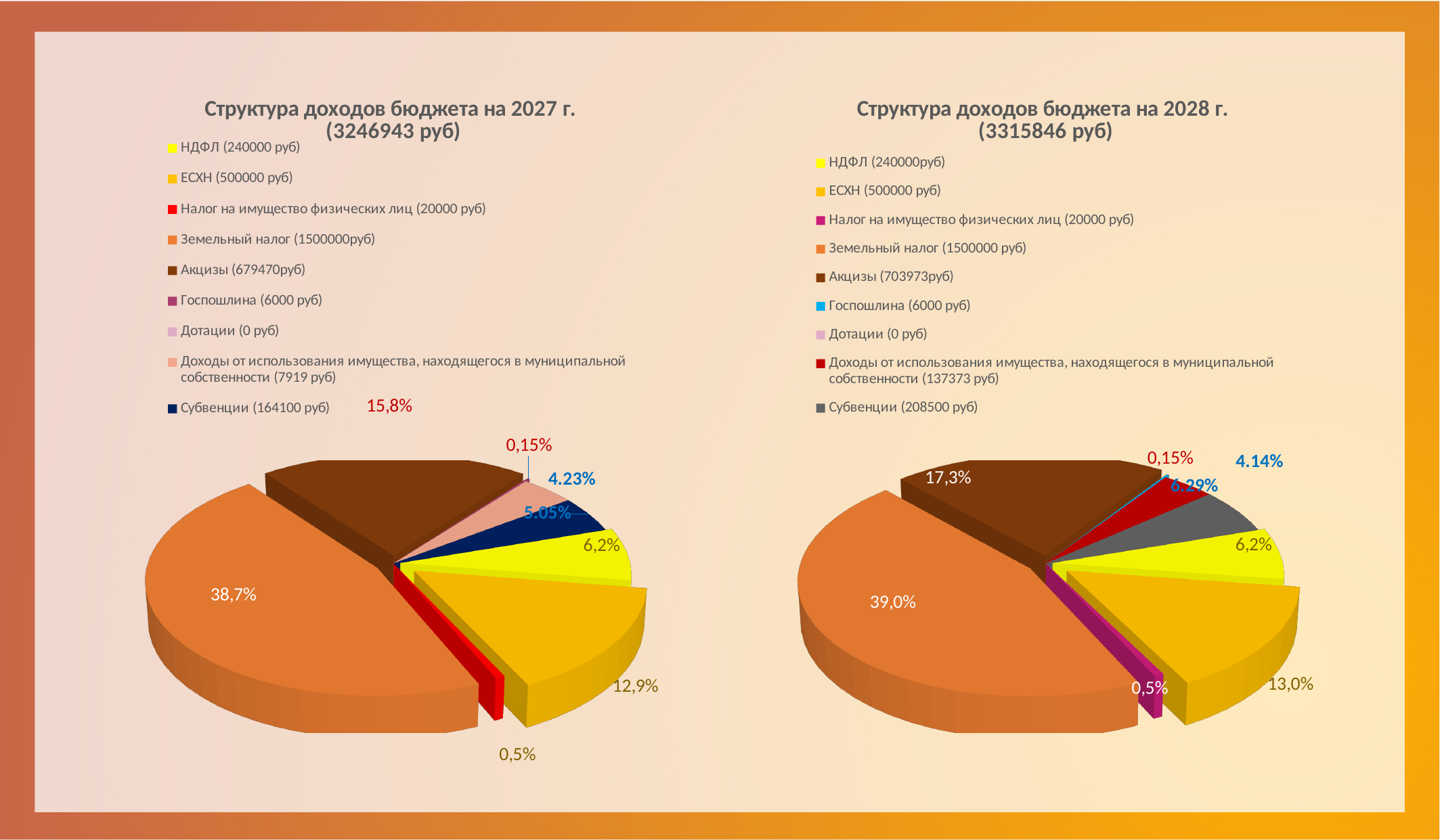
What kind of chart is used on the left side of the slide (Структура доходов бюджета на 2027 г.)? pie chart In the chart 'Структура доходов бюджета на 2027 г.', what percentage is shown for ЕСХН? 12,9% In the chart 'Структура доходов бюджета на 2028 г.', what share of the pie is labelled for Земельный налог? 39,0% In the chart 'Структура доходов бюджета на 2027 г.', what share of the pie is labelled for Земельный налог? 38,7% In the chart 'Структура доходов бюджета на 2028 г.', which is larger: the slice for ЕСХН or the slice for НДФЛ? ЕСХН In the chart 'Структура доходов бюджета на 2027 г.', which category has the largest slice? Земельный налог In the chart 'Структура доходов бюджета на 2028 г.', what percentage is shown for НДФЛ? 6,2% In the chart 'Структура доходов бюджета на 2028 г.', what amount does the legend give for Субвенции? 208500 руб What total budget amount is shown in the title of the chart 'Структура доходов бюджета на 2027 г.'? 3246943 руб In the chart 'Структура доходов бюджета на 2028 г.', what percentage is shown for Акцизы? 17,3% What is the difference between the Земельный налог share in the 2028 chart (39,0%) and in the 2027 chart (38,7%)? 0,3% In the chart 'Структура доходов бюджета на 2027 г.', how many categories does the legend list? 9